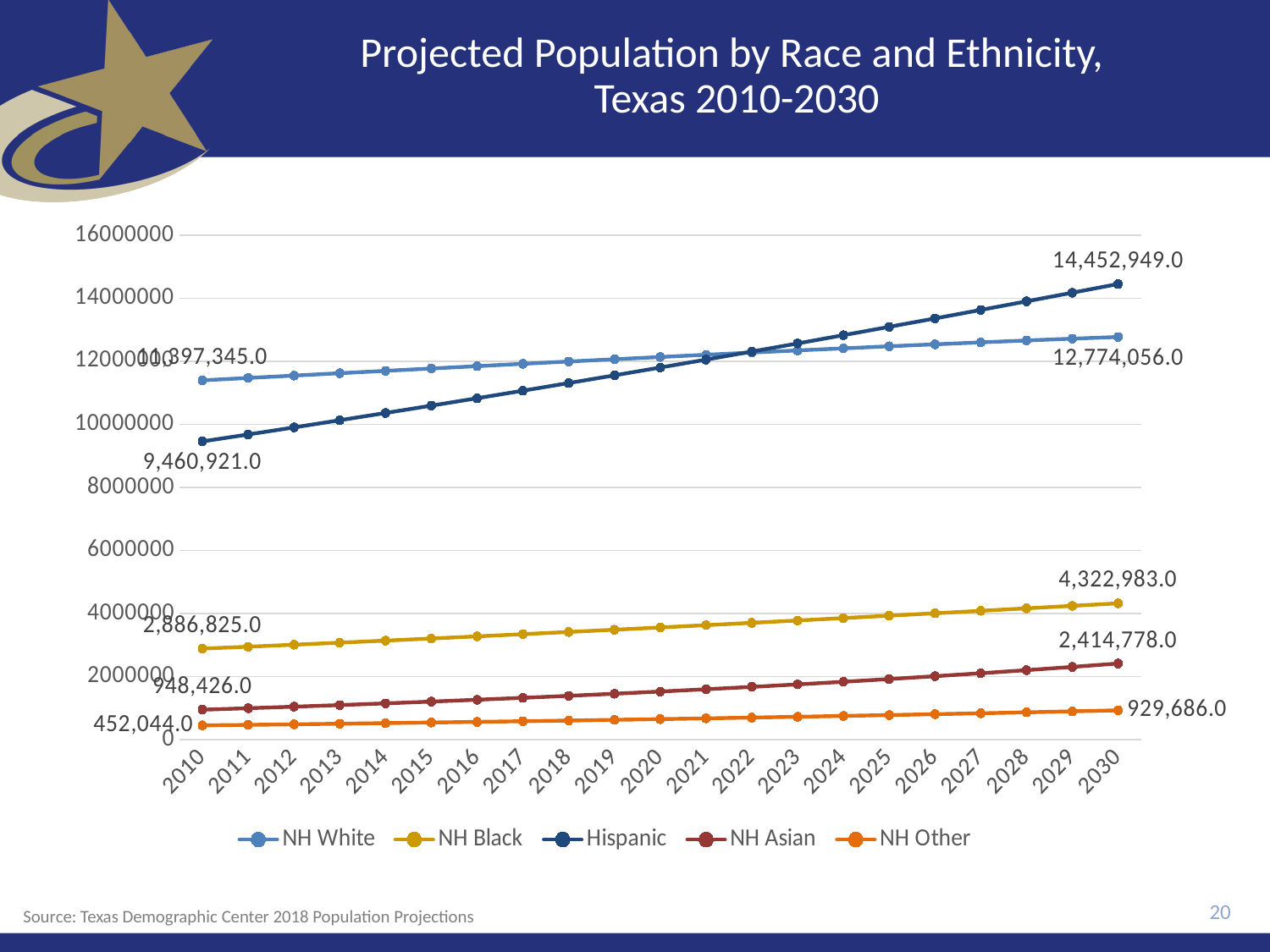
In 2030, which is larger: the Hispanic population or the NH White population? Hispanic Which group has the lowest projected population in 2010? NH Other How many series does the legend list? 5 Which group has the highest projected population in 2030? Hispanic What is the projected Hispanic population in 2030? 14,452,949.0 What type of chart is shown on the slide? line chart What is the projected NH Other population in 2030? 929,686.0 Is the NH Asian population in 2020 greater or less than 2000000? less By how much is the Hispanic population projected to grow from 2010 to 2030? 4,992,028.0 What is the projected NH Black population in 2010? 2,886,825.0 What is the projected Hispanic population in 2010? 9,460,921.0 What is the projected NH White population in 2030? 12,774,056.0